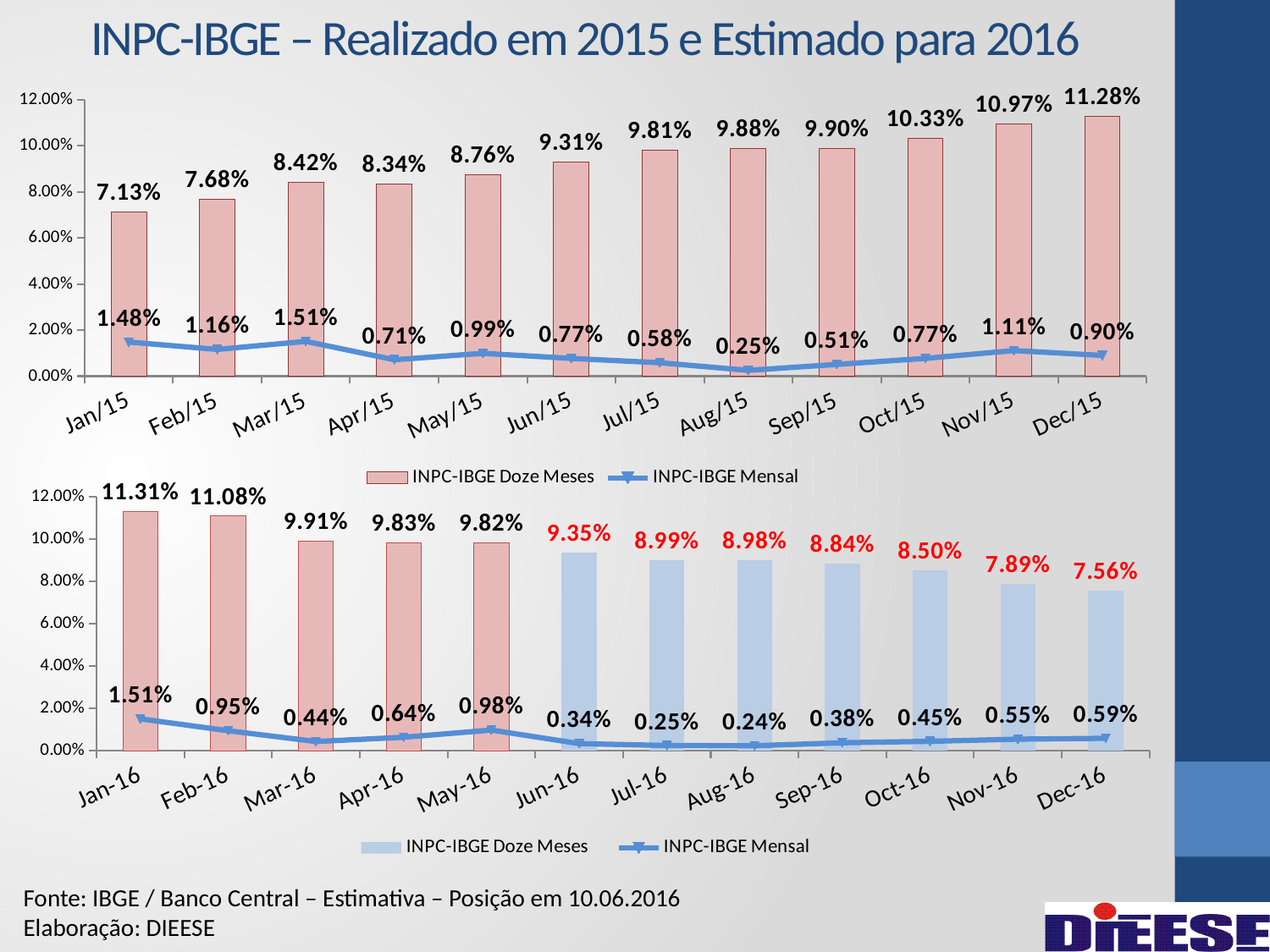
In the top chart (2015), what is the INPC-IBGE Mensal value for Aug/15? 0.25% In the top chart (2015), does the INPC-IBGE Doze Meses series generally rise or fall from Jan/15 to Dec/15? rise How many series does the legend of the top chart (2015) list? 2 How many months are shown on the x axis of the bottom chart (2016)? 12 In the top chart (2015), which month has the highest INPC-IBGE Mensal value? Mar/15 In the top chart (2015), what is the difference between the Doze Meses values for Dec/15 and Jan/15? 4.15% In the bottom chart (2016), does the INPC-IBGE Doze Meses series rise or fall from Jan-16 to Dec-16? fall In the bottom chart (2016), which month has the lowest INPC-IBGE Mensal value? Aug-16 In the top chart (2015), which month has the lowest INPC-IBGE Doze Meses value? Jan/15 In the top chart (2015), what is the INPC-IBGE Doze Meses value for Dec/15? 11.28% In the bottom chart (2016), what is the INPC-IBGE Doze Meses value for Jun-16? 9.35% In the bottom chart (2016), which is larger, the Doze Meses value for Jan-16 or for Dec-16? Jan-16